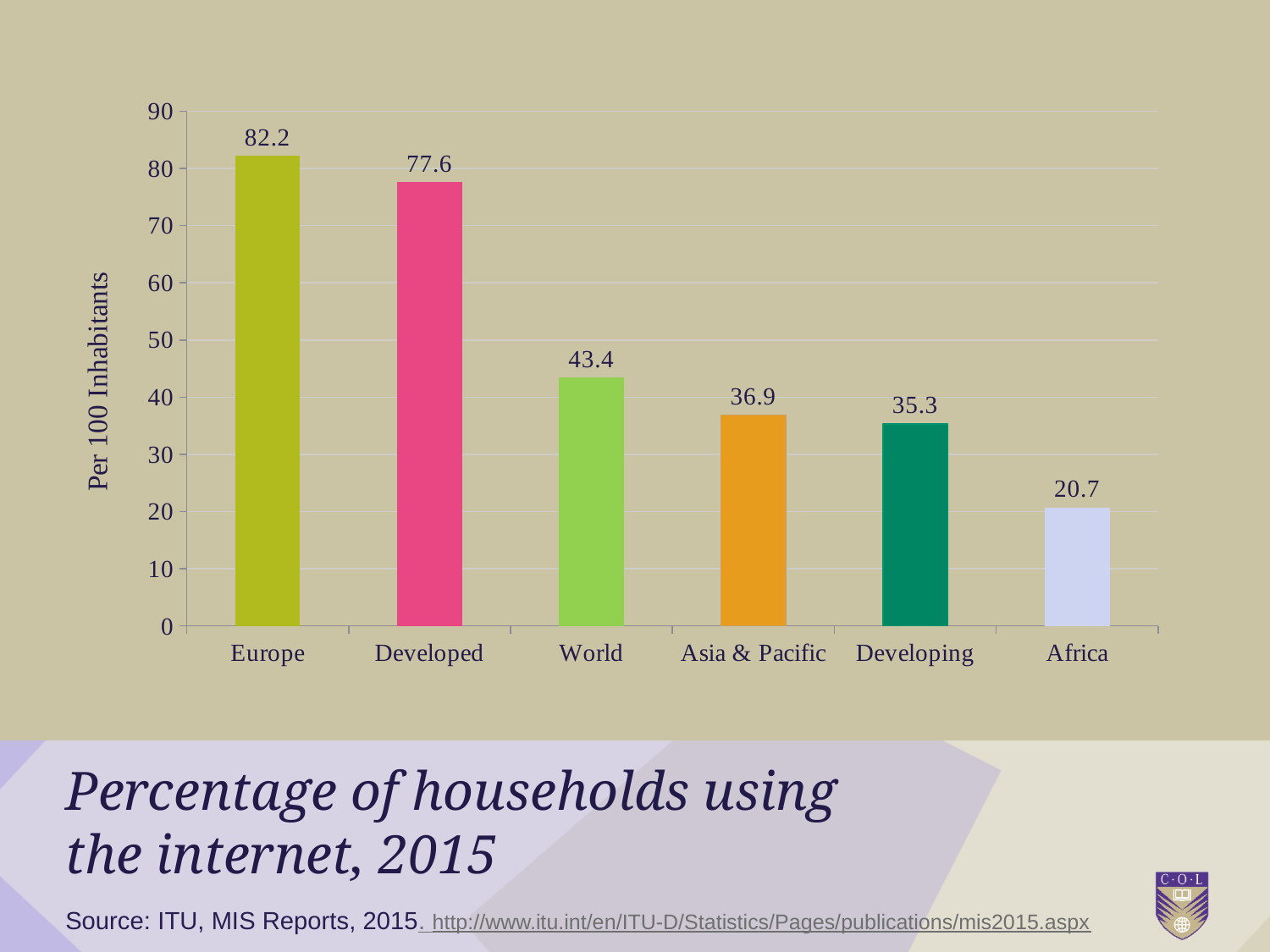
What is the value for Africa? 20.7 What is the value for Europe? 82.2 What is the difference between the values for Europe and Developed? 4.6 Is the value for Developed greater or less than 70? greater What is the value for Asia & Pacific? 36.9 What kind of chart is shown on the slide? bar chart What is the label of the vertical axis? Per 100 Inhabitants Which is larger, the value for World or the value for Developing? World What is the difference between the values for World and Africa? 22.7 Which category has the lowest value? Africa How many categories are shown on the x axis? 6 Which category has the highest value? Europe